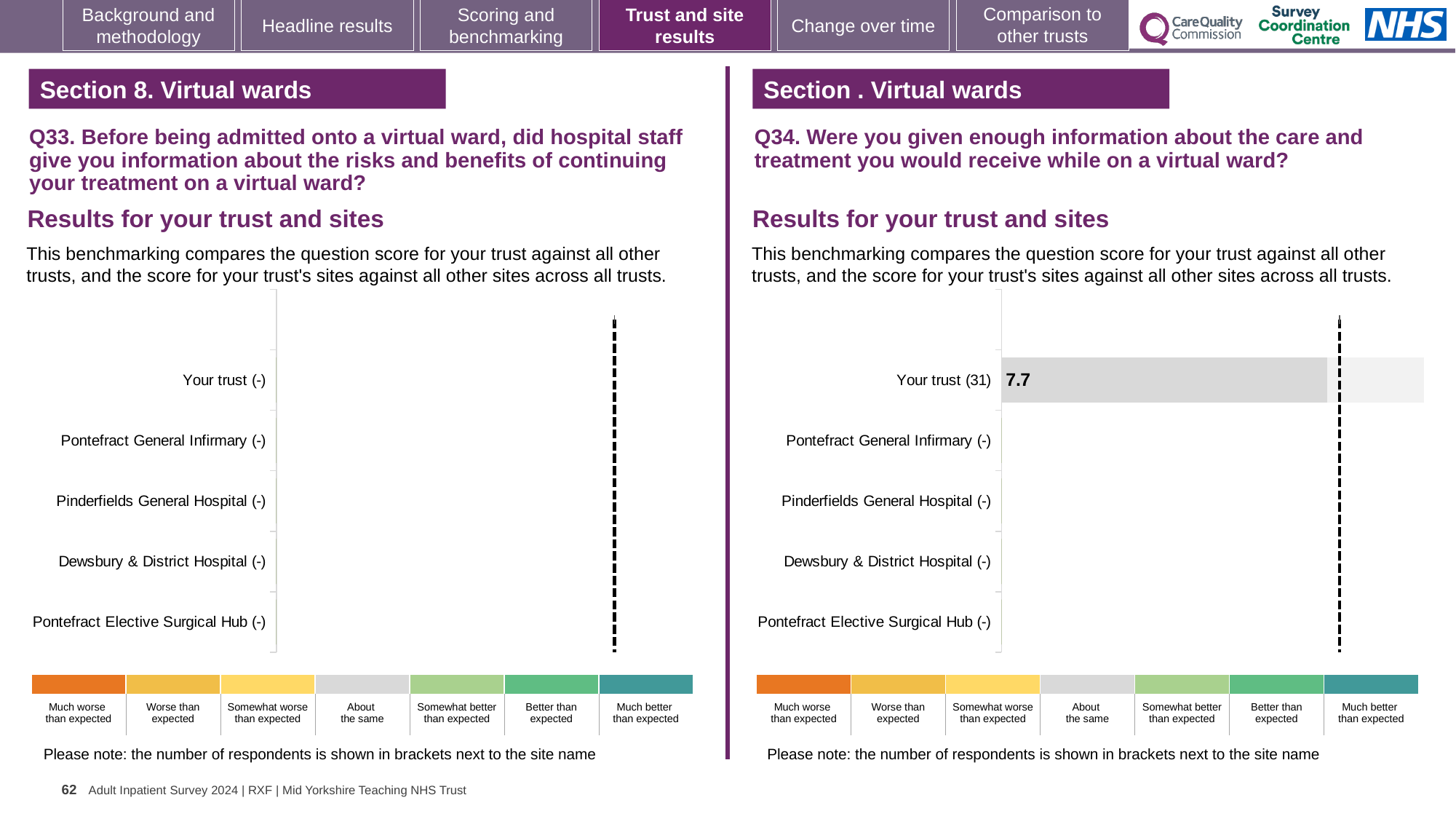
In the Q34 chart on the right, which category is the only one with a plotted bar? Your trust (31) How many site/trust categories are listed on the y axis of the Q34 chart on the right? 5 How many benchmark bands are shown in the colour key below the Q33 chart on the left? 7 In the Q34 chart on the right, is the value for Your trust greater or less than 5? greater In the Q33 chart on the left, what is the number of respondents shown next to Pontefract General Infirmary? - What kind of chart is the Q34 chart on the right? Bar chart In the Q34 chart on the right, which benchmark band does the grey colour of the Your trust bar correspond to in the colour key? About the same In the Q34 chart on the right, how many respondents are shown in brackets next to Your trust? 31 How many site/trust categories are listed on the y axis of the Q33 chart on the left? 5 In the Q34 chart on the right, what is the number of respondents shown next to Dewsbury & District Hospital? - In the Q34 chart on the right, what is the score shown for Your trust? 7.7